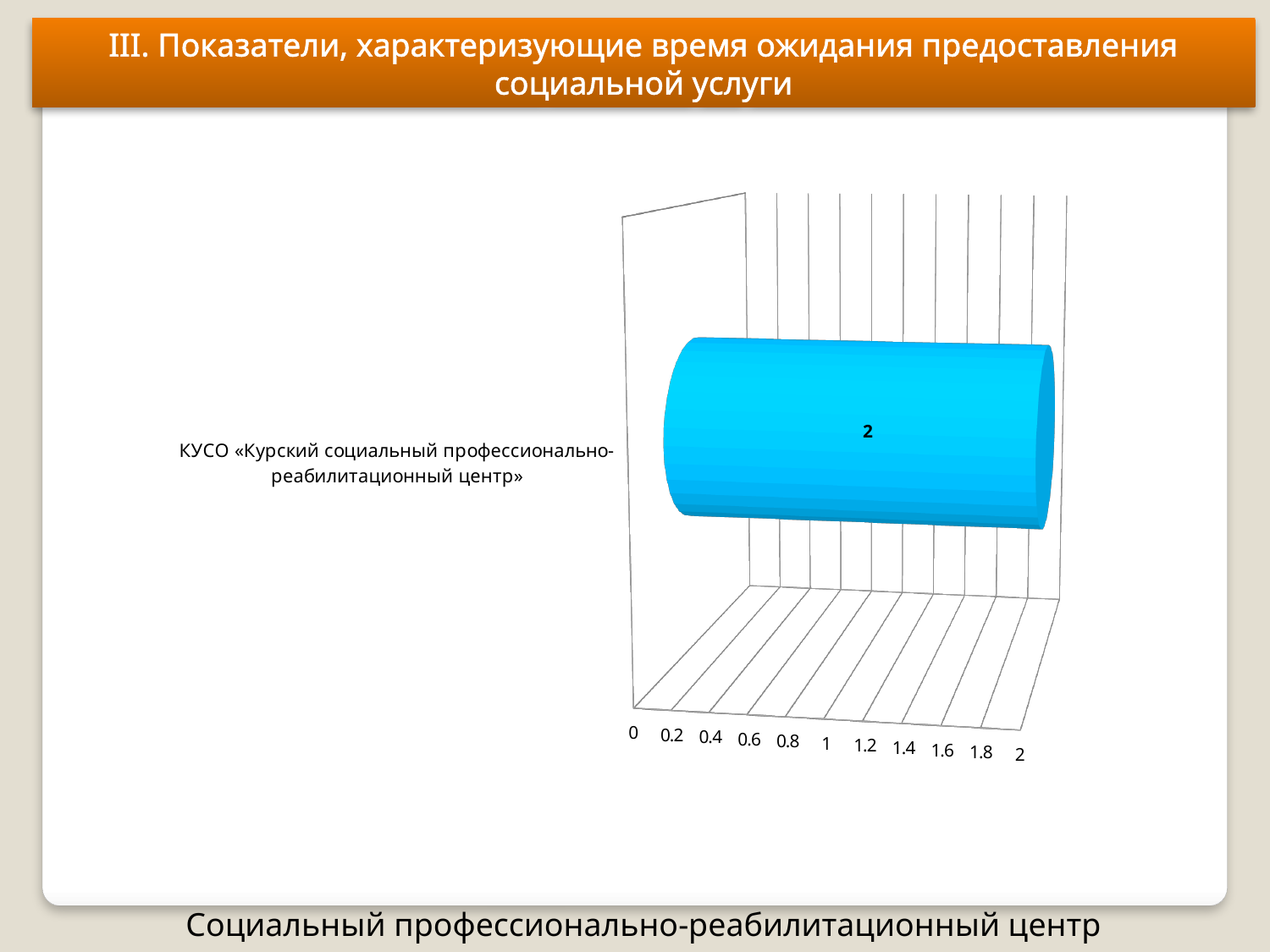
What kind of chart is shown on the slide? bar chart Is the value for КУСО «Курский социальный профессионально-реабилитационный центр» greater or less than 1? greater How many categories are plotted in the chart? 1 Is the value for КУСО «Курский социальный профессионально-реабилитационный центр» greater or less than 0.6? greater What value is shown for КУСО «Курский социальный профессионально-реабилитационный центр»? 2 What is the name of the only category shown in the chart? КУСО «Курский социальный профессионально-реабилитационный центр» What is the highest tick value shown on the value axis? 2